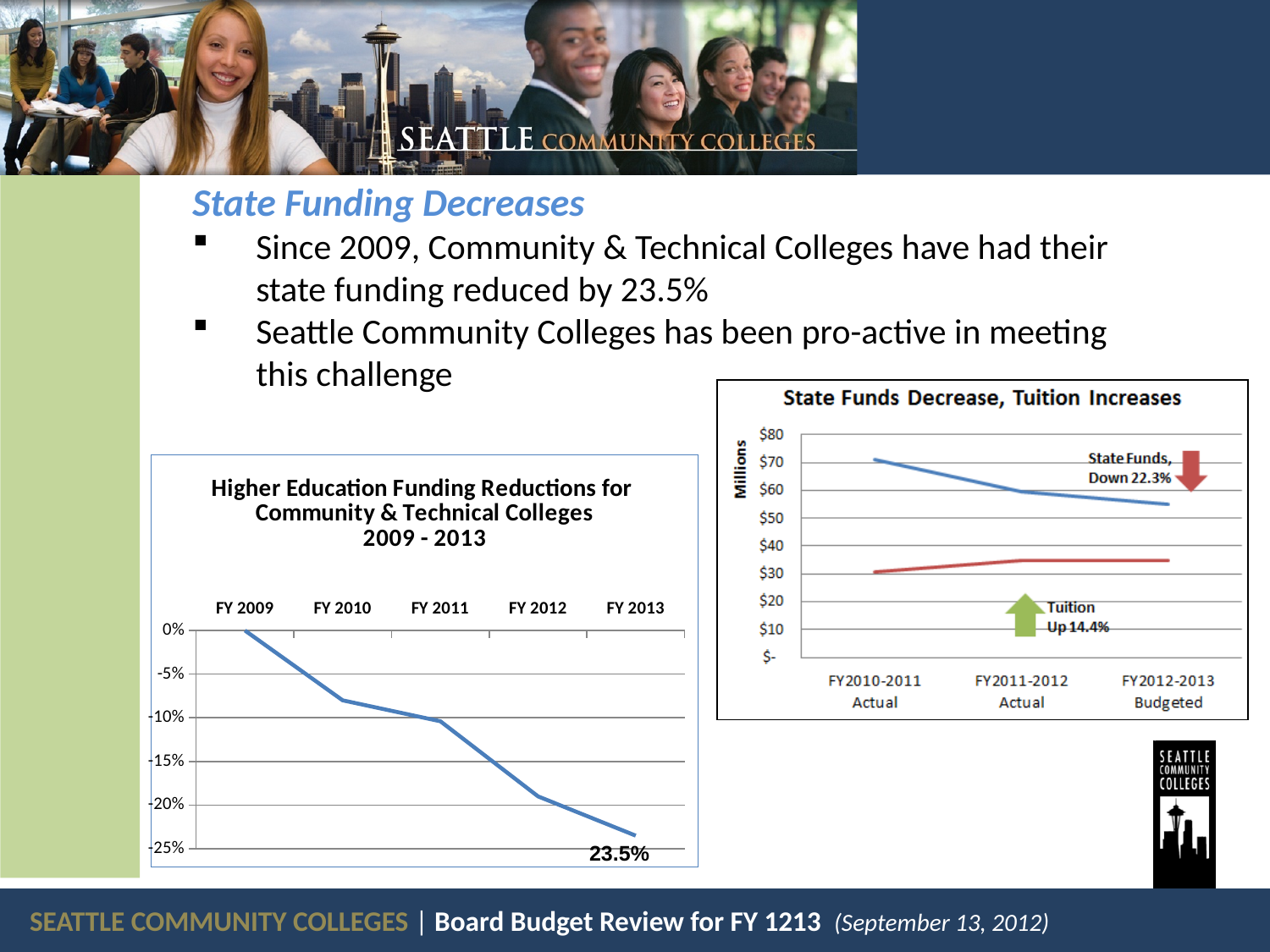
In the 'State Funds Decrease, Tuition Increases' chart, how many fiscal year periods are shown on the x axis? 3 In the 'State Funds Decrease, Tuition Increases' chart, is the State Funds value for FY2010-2011 Actual greater or less than $60? greater In the 'State Funds Decrease, Tuition Increases' chart, which is larger for FY2012-2013 Budgeted, State Funds or Tuition? State Funds In the 'State Funds Decrease, Tuition Increases' chart, by what percentage does the annotation say State Funds are down? 22.3% In the 'Higher Education Funding Reductions' chart, is the value for FY 2010 greater or less than -10%? greater What kind of chart is the 'State Funds Decrease, Tuition Increases' chart? line chart What kind of chart is the 'Higher Education Funding Reductions for Community & Technical Colleges 2009 - 2013' chart? line chart In the 'Higher Education Funding Reductions' chart, what value is labelled for FY 2013? 23.5% In the 'Higher Education Funding Reductions' chart, which fiscal year has the lowest value? FY 2013 In the 'Higher Education Funding Reductions' chart, is the value for FY 2012 greater or less than -15%? less In the 'Higher Education Funding Reductions' chart, do the values rise or fall from FY 2009 to FY 2013? fall In the 'Higher Education Funding Reductions' chart, how many fiscal years are shown on the x axis? 5